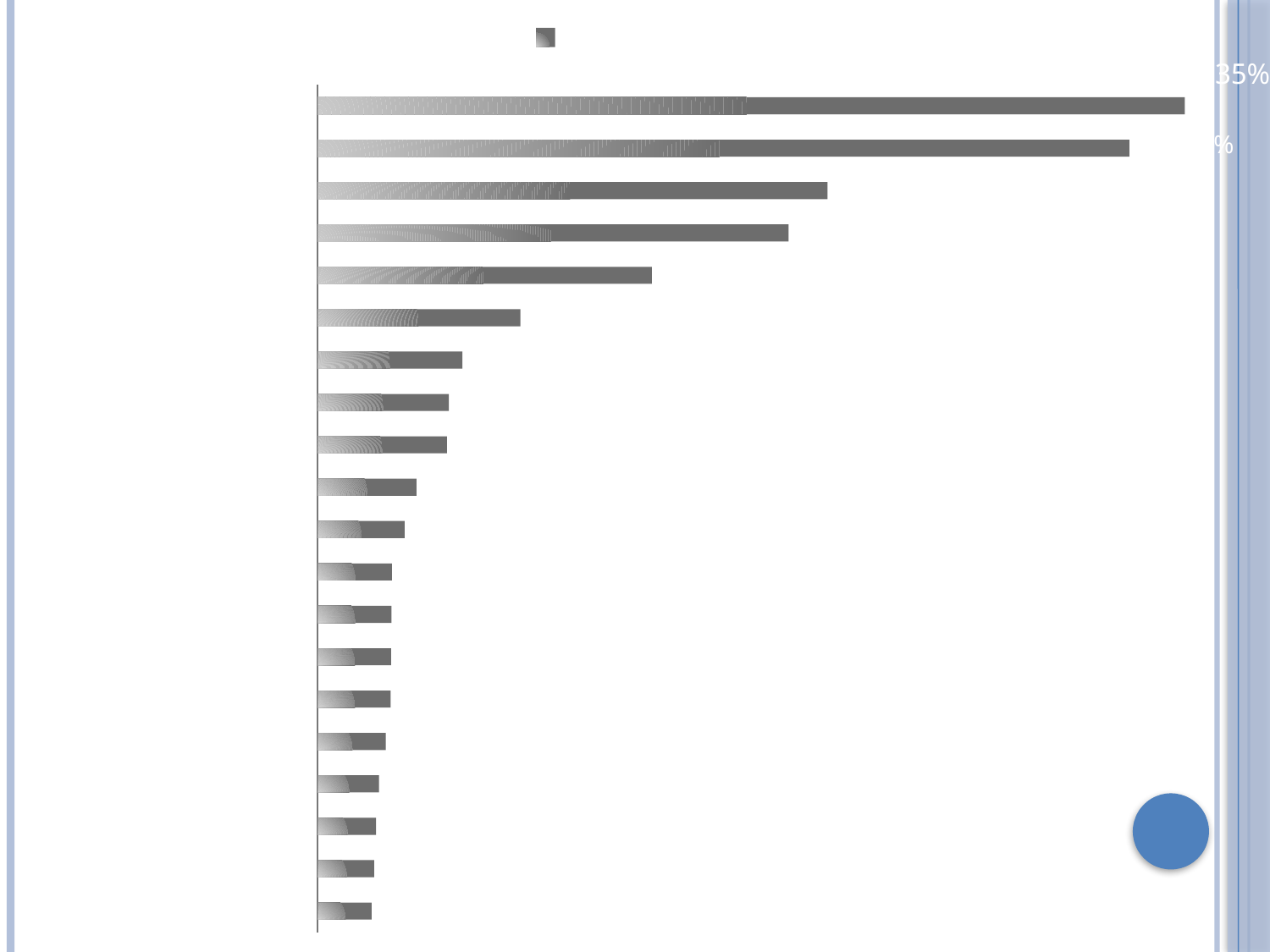
Do the bar lengths increase or decrease from the top of the chart to the bottom? decrease Are the bars arranged horizontally or vertically? horizontally How many entries does the chart's legend show? 1 What colour are the bars in the chart? grey Is the shortest bar at the top or the bottom of the chart? bottom Is the longest bar at the top or the bottom of the chart? top What kind of chart is shown on the slide? bar chart How many bars are plotted in the chart? 20